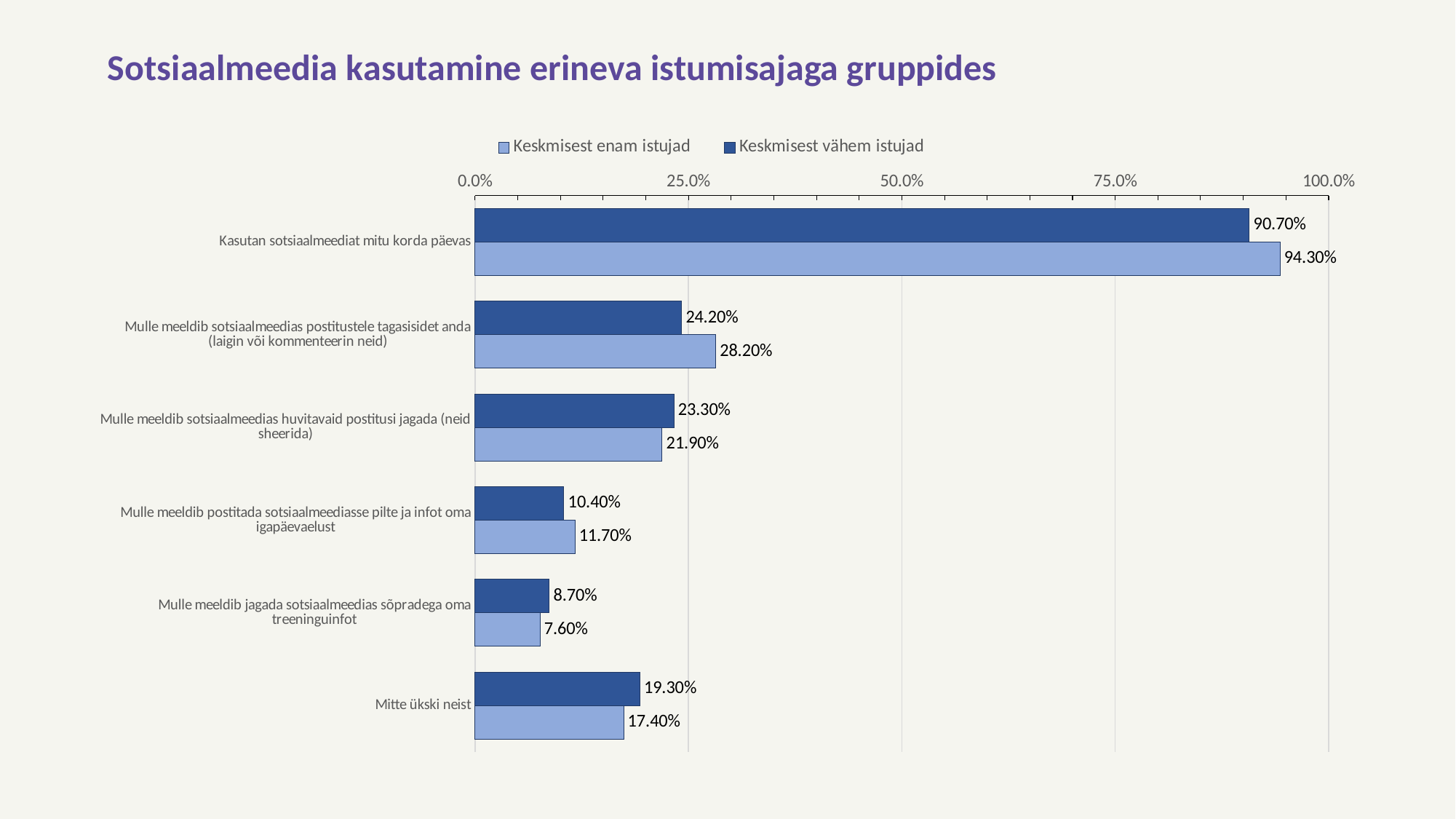
What is the difference between the "Keskmisest enam istujad" and "Keskmisest vähem istujad" values for "Mulle meeldib sotsiaalmeedias postitustele tagasisidet anda (laigin või kommenteerin neid)"? 4.00% What is the value for "Keskmisest enam istujad" in the category "Kasutan sotsiaalmeediat mitu korda päevas"? 94.30% What is the value for "Keskmisest vähem istujad" in the category "Mulle meeldib postitada sotsiaalmeediasse pilte ja infot oma igapäevaelust"? 10.40% What is the difference between the "Keskmisest enam istujad" and "Keskmisest vähem istujad" values for "Kasutan sotsiaalmeediat mitu korda päevas"? 3.60% Which category has the lowest value for "Keskmisest enam istujad"? Mulle meeldib jagada sotsiaalmeedias sõpradega oma treeninguinfot Is the value for "Keskmisest enam istujad" in "Mulle meeldib sotsiaalmeedias postitustele tagasisidet anda (laigin või kommenteerin neid)" greater or less than 25.0%? greater What is the value for "Keskmisest vähem istujad" in the category "Mitte ükski neist"? 19.30% Which category has the highest value for "Keskmisest vähem istujad"? Kasutan sotsiaalmeediat mitu korda päevas How many categories are shown on the chart? 6 How many series does the legend list? 2 For "Mulle meeldib sotsiaalmeedias huvitavaid postitusi jagada (neid sheerida)", which series has the larger value? Keskmisest vähem istujad What kind of chart is shown on the slide? Bar chart